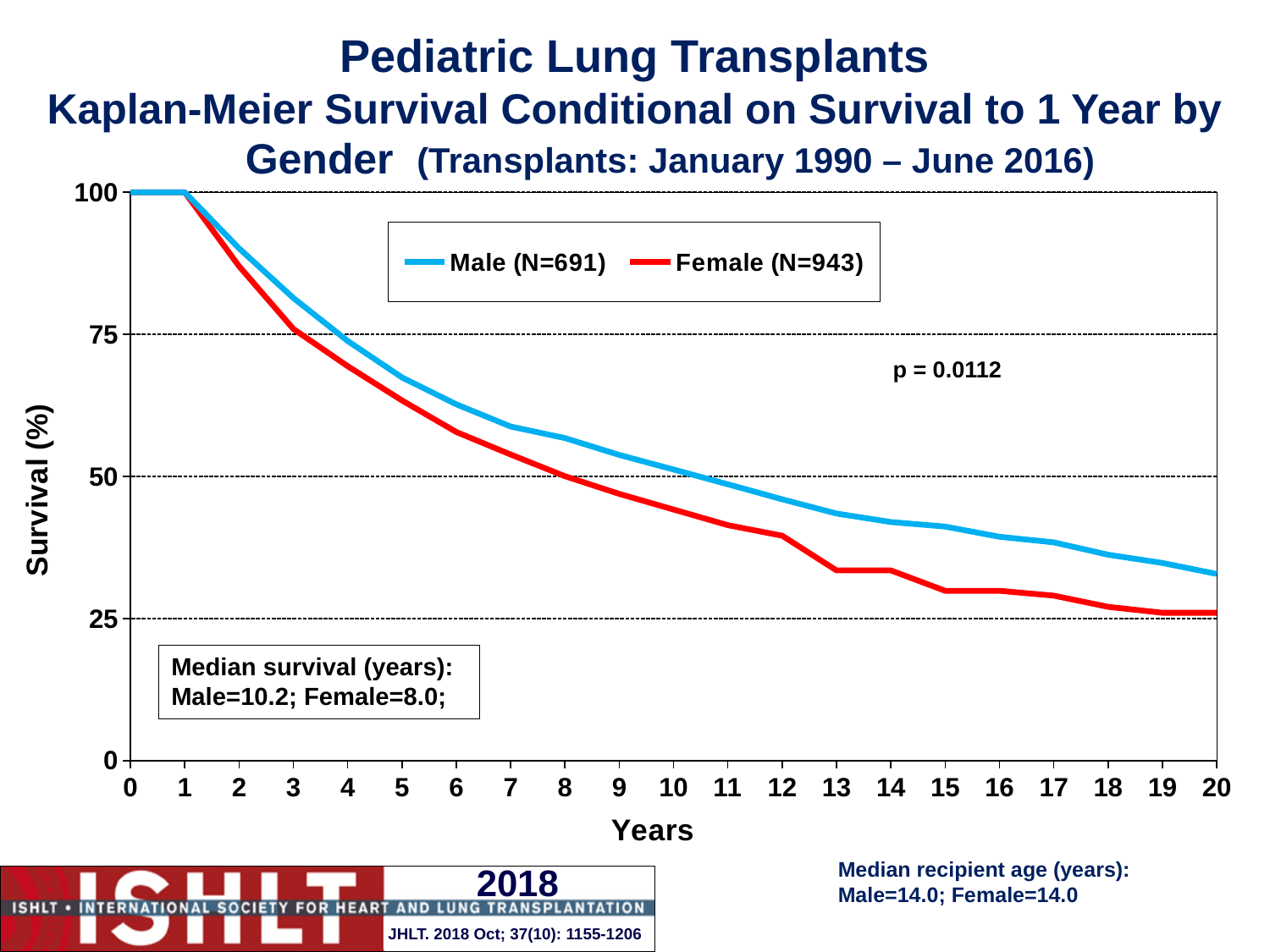
What is the median survival in years for Male recipients, as stated in the text box? 10.2 Is the Male survival value at year 20 greater or less than 25? greater What is the difference in median survival (years) between Male and Female recipients? 2.2 What is the survival value for both Male and Female at year 1? 100 What p-value is shown on the chart? p = 0.0112 What are the two series named in the legend? Male (N=691) and Female (N=943) Is the Female survival value at year 10 greater or less than 50? less Do the survival curves rise or fall as years increase along the x axis? fall What kind of chart is shown on the slide? line chart At year 15, which series has the higher survival, Male or Female? Male What is the median survival in years for Female recipients, as stated in the text box? 8.0 How many series does the legend list? 2